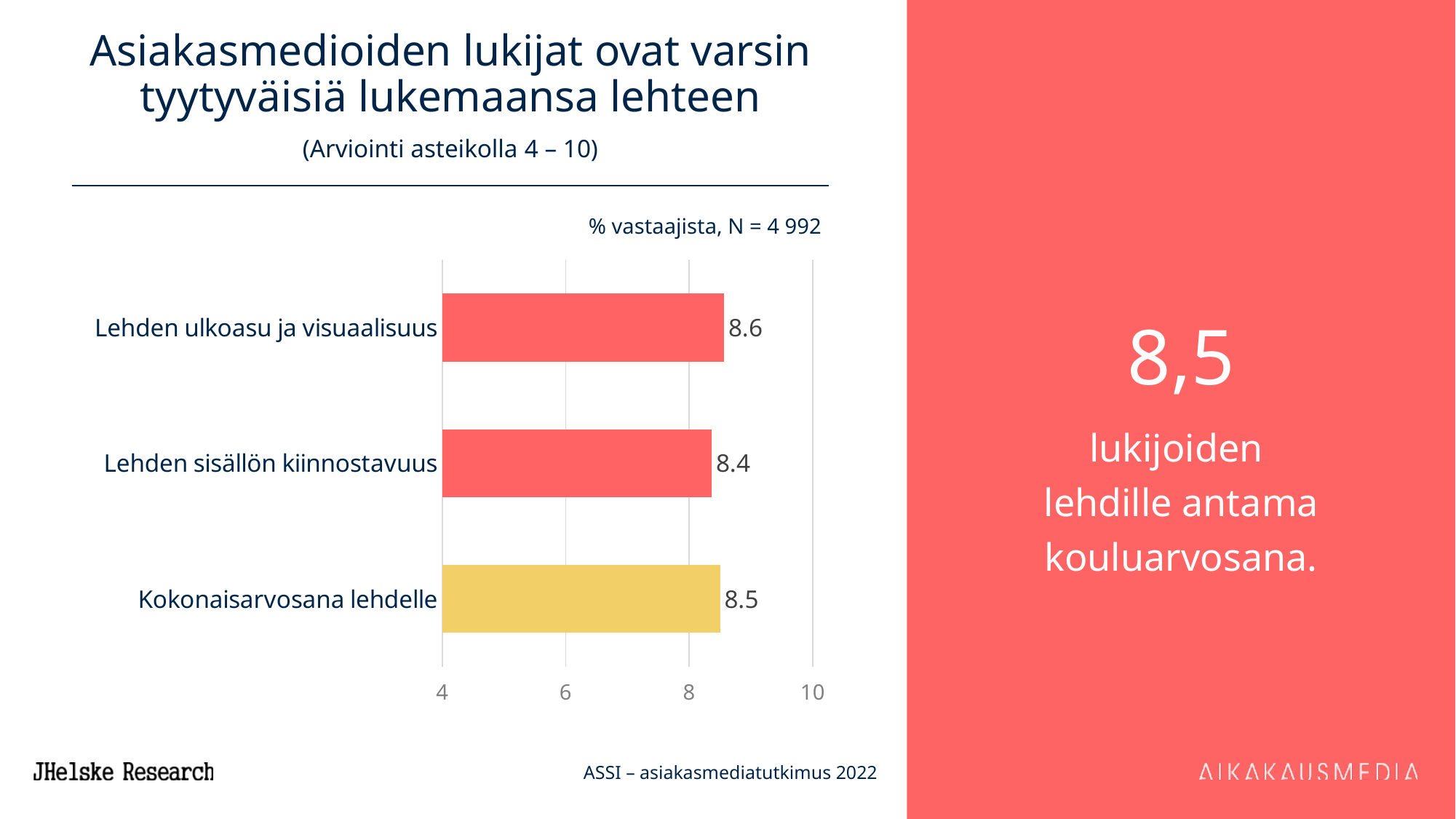
What is the difference between the values for Lehden ulkoasu ja visuaalisuus and Lehden sisällön kiinnostavuus? 0.2 Is the value for Lehden sisällön kiinnostavuus greater or less than 8? greater Which is larger, the value for Lehden ulkoasu ja visuaalisuus or the value for Kokonaisarvosana lehdelle? Lehden ulkoasu ja visuaalisuus What is the value for Kokonaisarvosana lehdelle? 8.5 Which category's bar is coloured yellow rather than red? Kokonaisarvosana lehdelle Which category has the lowest value? Lehden sisällön kiinnostavuus Which category has the highest value? Lehden ulkoasu ja visuaalisuus What kind of chart is shown on the slide? bar chart What is the value for Lehden ulkoasu ja visuaalisuus? 8.6 How many categories are shown in the chart? 3 What is the difference between the values for Kokonaisarvosana lehdelle and Lehden sisällön kiinnostavuus? 0.1 What is the value for Lehden sisällön kiinnostavuus? 8.4